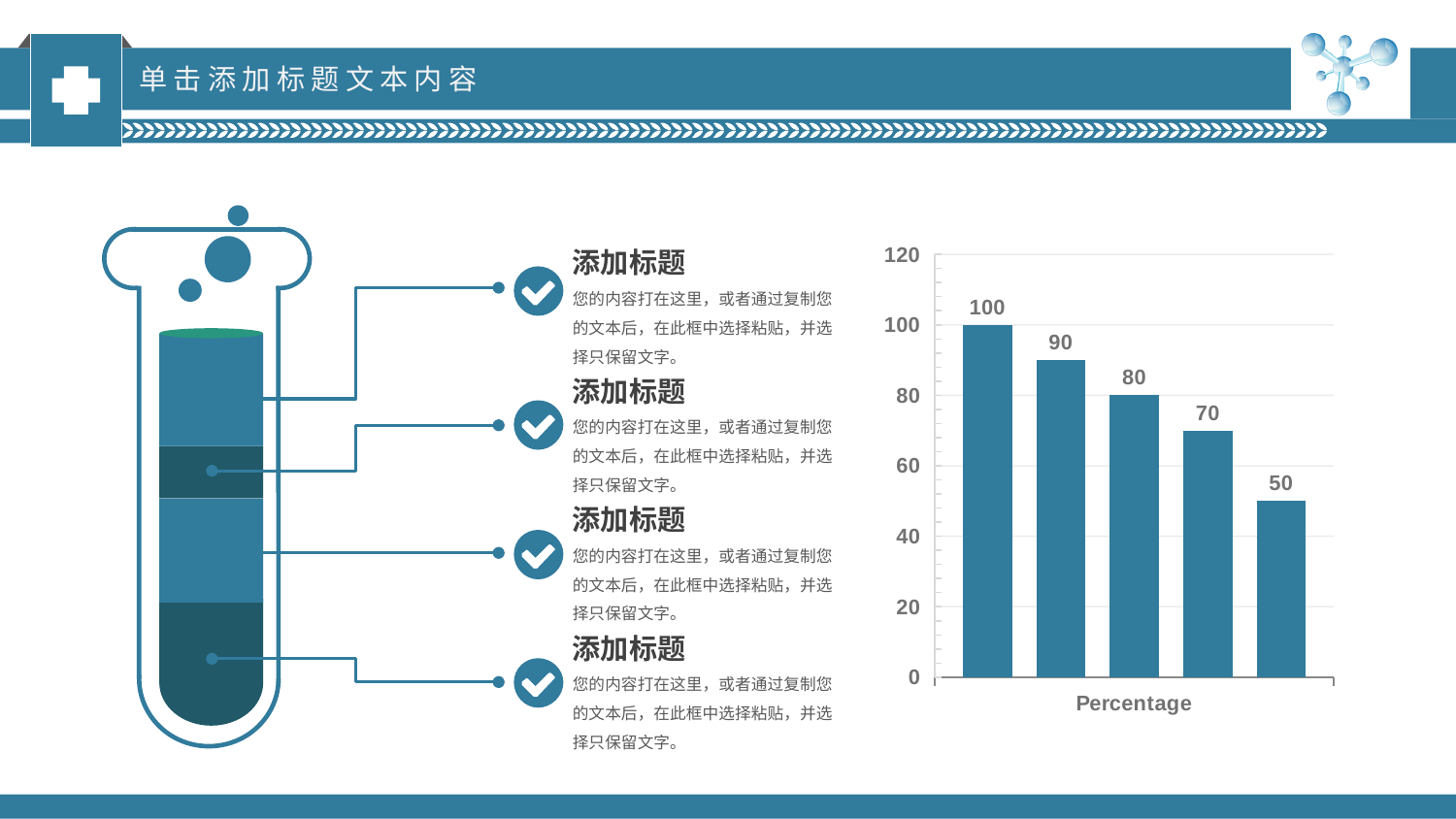
Which is larger, the second bar or the fourth bar? The second bar (90) Which bar has the lowest value in the chart? The last (rightmost) bar, 50 What is the difference between the fourth bar and the fifth bar in the chart? 20 What is the value of the first (leftmost) bar in the chart? 100 Which bar has the highest value in the chart? The first (leftmost) bar, 100 What is the value of the third bar from the left in the chart? 80 What is the difference between the first bar and the last bar in the chart? 50 Do the bar values rise or fall from left to right along the x axis? Fall What type of chart is shown on the slide? Bar chart How many bars are plotted in the chart? 5 What is the value of the last (rightmost) bar in the chart? 50 What is the label shown below the x axis of the chart? Percentage